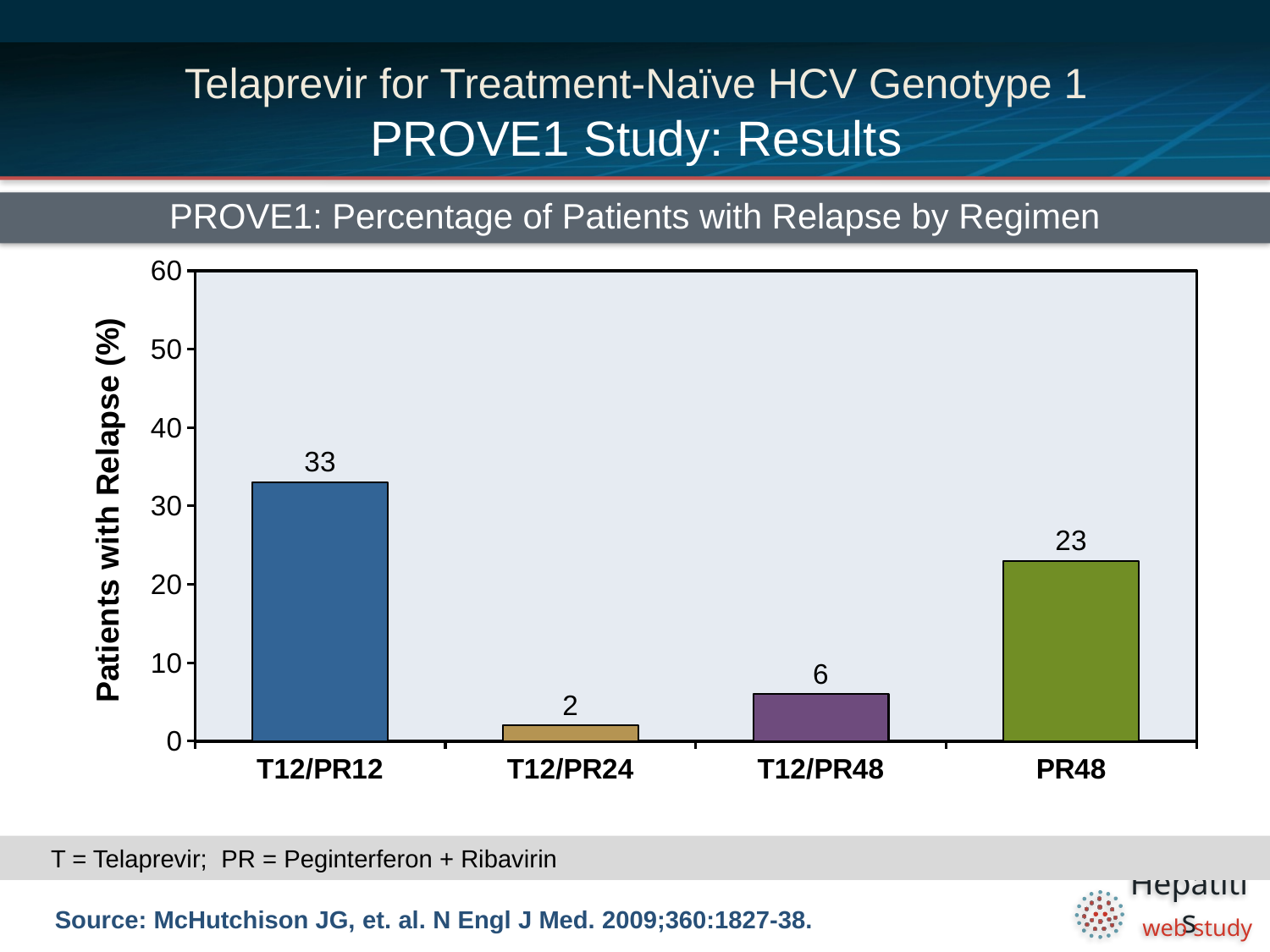
Which regimen has the lowest percentage of patients with relapse? T12/PR24 What is the percentage of patients with relapse for the T12/PR12 regimen? 33 What is the difference in relapse percentage between T12/PR48 and T12/PR24? 4 What is the label of the y-axis on the chart? Patients with Relapse (%) Is the relapse percentage for T12/PR12 greater or less than 30? greater Which regimen has the highest percentage of patients with relapse? T12/PR12 What is the percentage of patients with relapse for the T12/PR24 regimen? 2 What is the percentage of patients with relapse for the PR48 regimen? 23 Which regimen has a higher relapse percentage, T12/PR48 or PR48? PR48 How many regimens are shown on the chart? 4 What is the difference in relapse percentage between T12/PR12 and PR48? 10 What kind of chart is shown on the slide? Bar chart